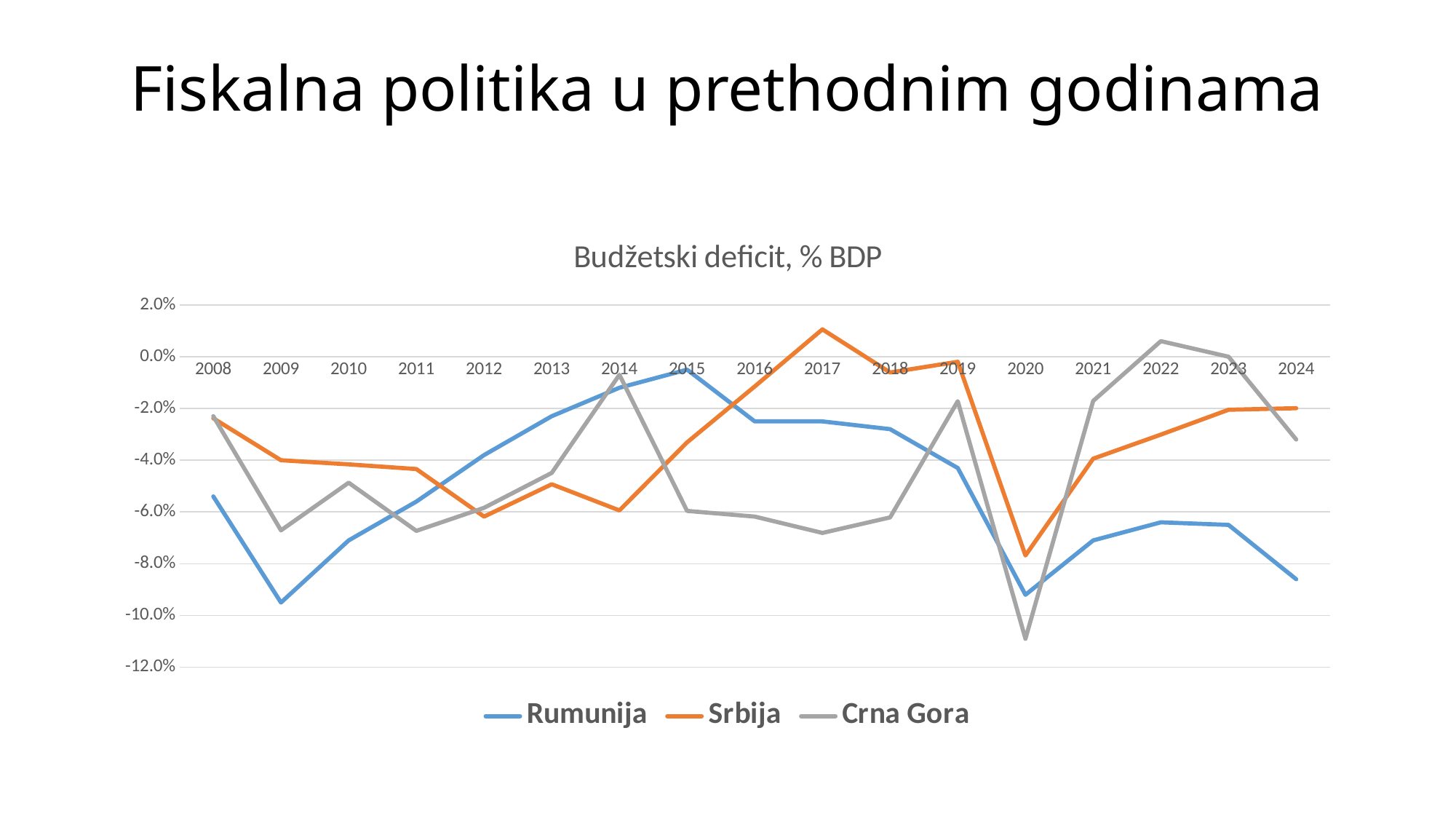
In 2024, which series has the higher value, Rumunija or Srbija? Srbija Is the value for Crna Gora in 2020 greater or less than -10.0%? less Is the value for Srbija in 2017 greater or less than 0.0%? greater Is the value for Rumunija in 2009 greater or less than -8.0%? less In which year does Crna Gora reach its lowest value? 2020 What is the title of the chart? Budžetski deficit, % BDP In which year does Srbija reach its highest value? 2017 How many series does the legend list? 3 Does the Rumunija line rise or fall from 2009 to 2015? rise How many years are plotted along the x axis? 17 What kind of chart is shown on the slide? line chart Which series is drawn in orange? Srbija